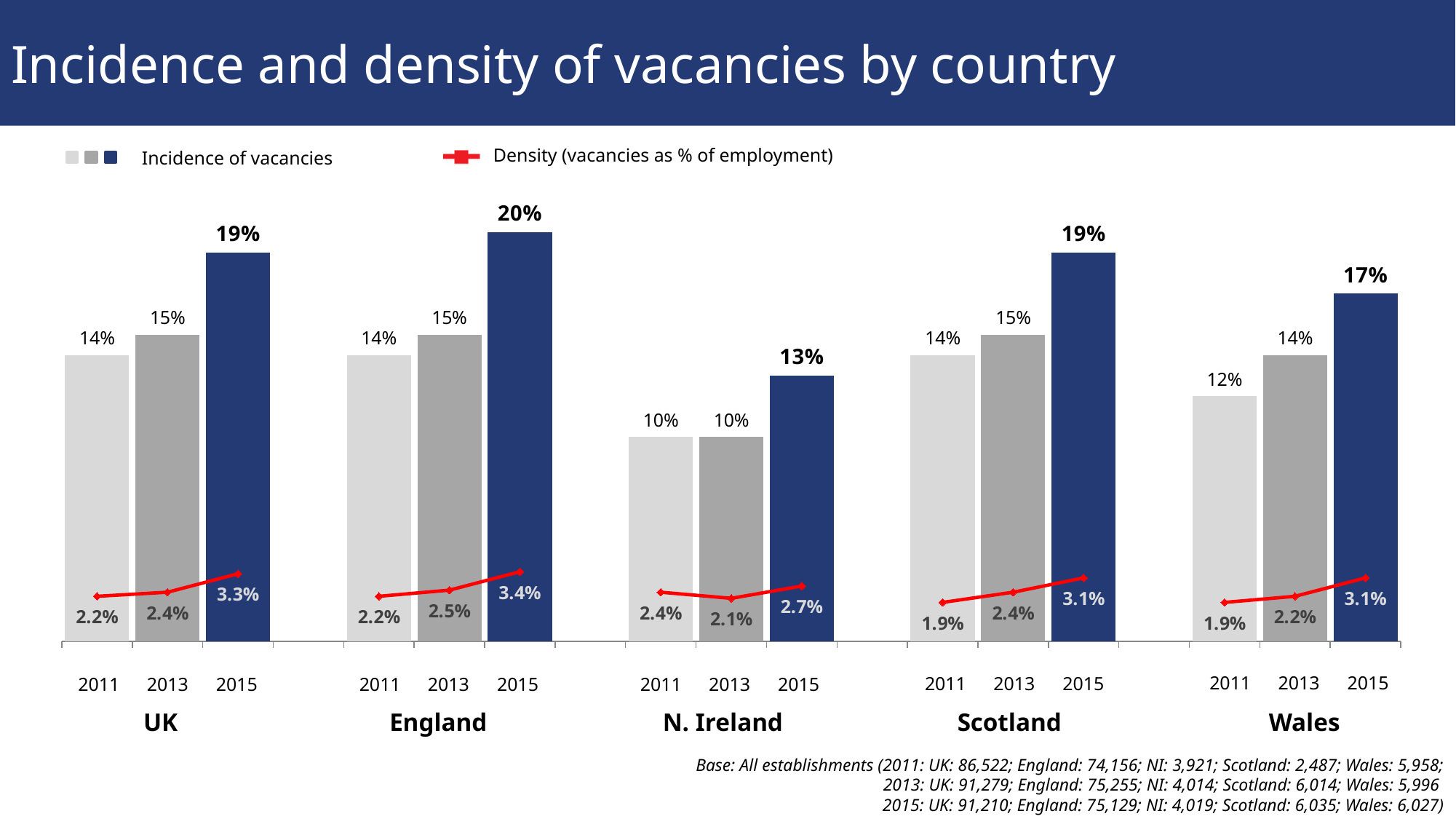
Which was higher in 2013: the density of vacancies in England or in N. Ireland? England What was the incidence of vacancies in Wales in 2011? 12% What does the red line on the chart represent? Density (vacancies as % of employment) What kind of chart is used to show the incidence of vacancies? Bar chart What was the density of vacancies (vacancies as % of employment) in Scotland in 2011? 1.9% By how many percentage points did the incidence of vacancies in the UK rise between 2013 and 2015? 4 percentage points What is the difference between the density of vacancies in England and in N. Ireland in 2015? 0.7 percentage points What was the incidence of vacancies in England in 2015? 20% How did the incidence of vacancies in Scotland change from 2011 to 2015? It rose How many countries or regions are shown on the chart? 5 Which country had the lowest incidence of vacancies in 2015? N. Ireland Which country had the highest incidence of vacancies in 2015? England